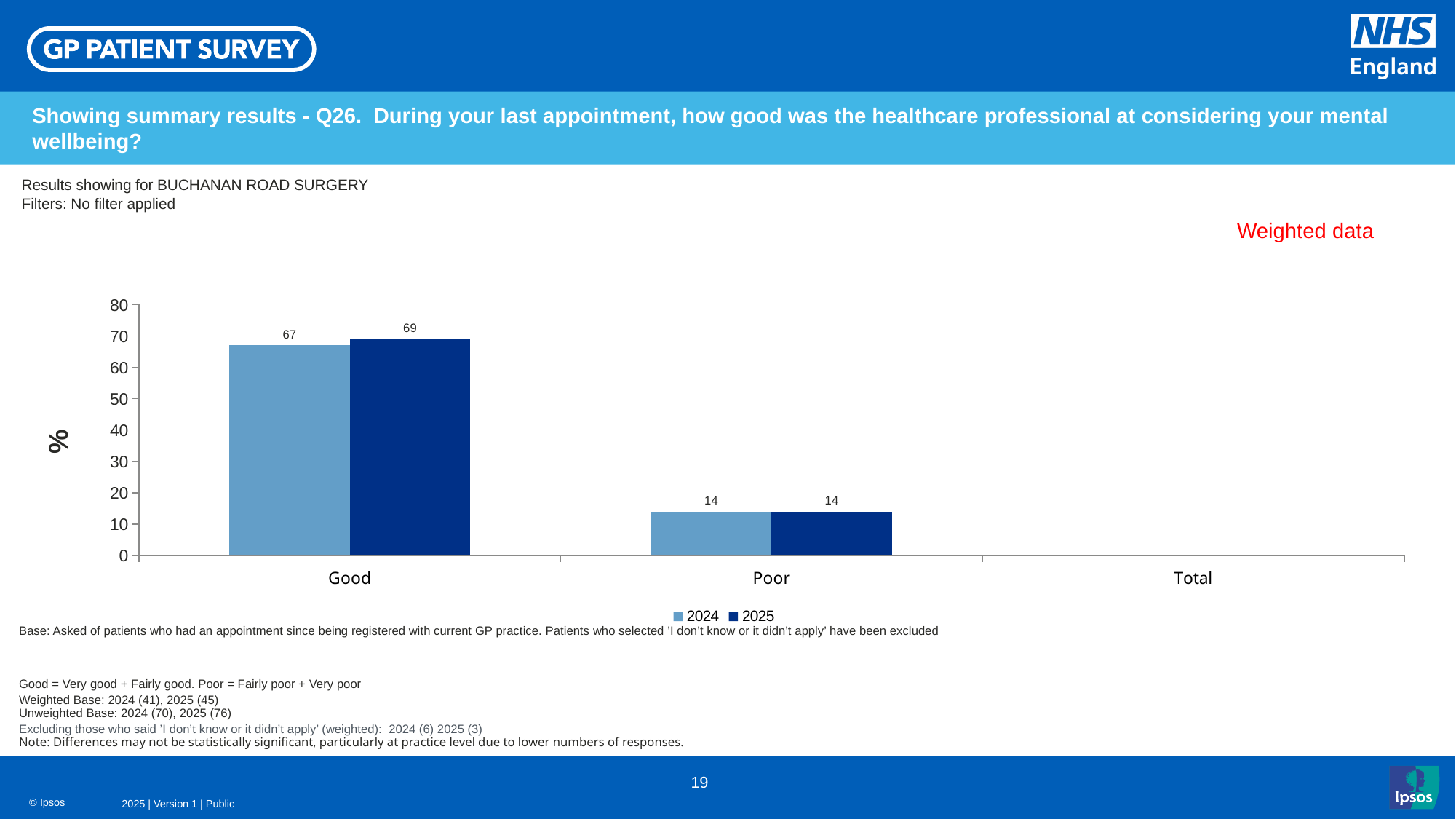
Which category has the highest value in 2025? Good What label is shown on the vertical axis of the chart? % What kind of chart is shown on the slide? Bar chart How many series does the legend list? 2 What is the value for Poor in 2024? 14 Which is larger, the Good value for 2024 or the Good value for 2025? 2025 What is the difference between the Good values for 2025 and 2024? 2 What is the value for Good in 2024? 67 What is the value for Good in 2025? 69 Which category has the lowest value in 2024? Poor What is the value for Poor in 2025? 14 What is the difference between the Good and Poor values in 2024? 53